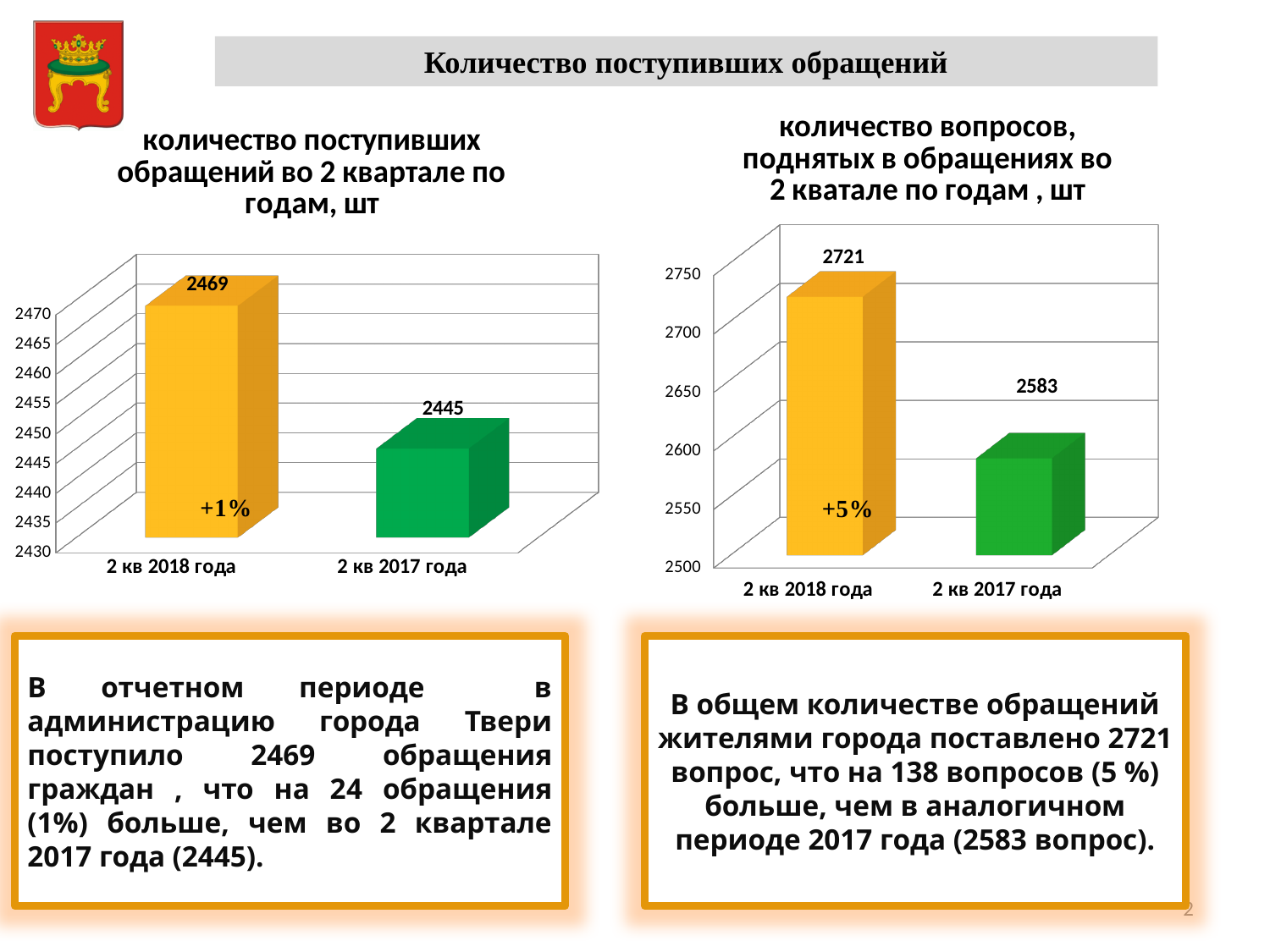
In the left chart, which category has the highest value? 2 кв 2018 года In the right chart, which is larger: the value for 2 кв 2018 года or 2 кв 2017 года? 2 кв 2018 года In the right chart, what is the value for 2 кв 2017 года? 2583 In the right chart, which category has the lowest value? 2 кв 2017 года In the right chart (количество вопросов, поднятых в обращениях во 2 кватале по годам, шт), what is the value for 2 кв 2018 года? 2721 In the left chart (количество поступивших обращений во 2 квартале по годам, шт), what is the value for 2 кв 2018 года? 2469 How many categories are shown in the left chart? 2 In the left chart, what is the value for 2 кв 2017 года? 2445 What kind of chart is the right chart? Bar chart In the left chart, what percentage change label is printed on the 2 кв 2018 года bar? +1% In the left chart, what is the difference between the values for 2 кв 2018 года and 2 кв 2017 года? 24 In the right chart, what is the difference between the values for 2 кв 2018 года and 2 кв 2017 года? 138